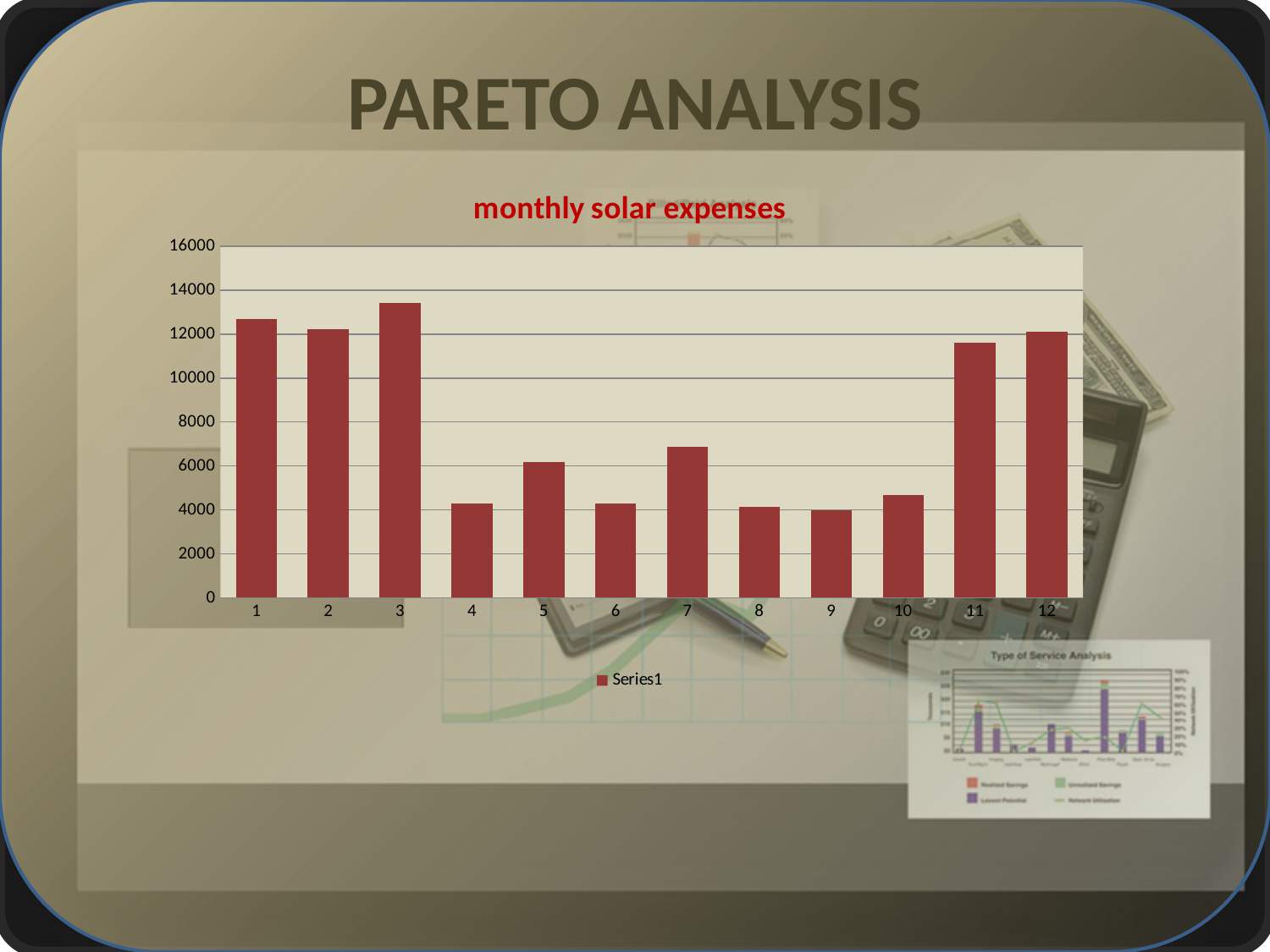
What type of chart is shown on the slide? bar chart Is the value for category 3 greater or less than 12000? greater Which has the larger value, category 3 or category 11? 3 Is the value for category 7 greater or less than 6000? greater Which category has the highest value in the chart? 3 Is the value for category 11 greater or less than 10000? greater Which has the larger value, category 1 or category 4? 1 How many categories are plotted on the x axis of the chart? 12 What is the title of the chart? monthly solar expenses How many series does the chart legend list? 1 What is the name of the series shown in the legend? Series1